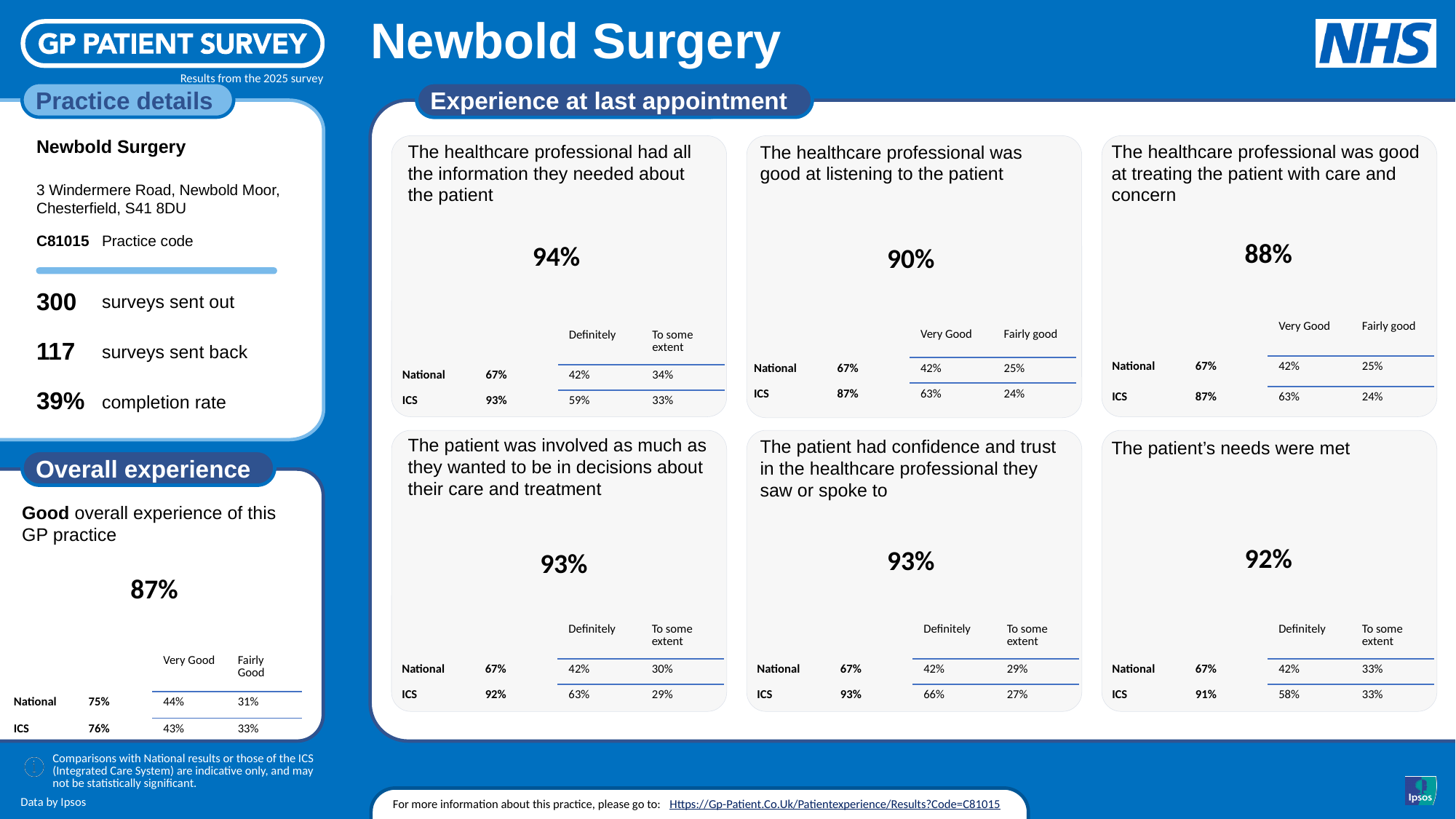
In the 'The patient had confidence and trust in the healthcare professional they saw or spoke to' panel, what is the ICS 'Definitely' value? 66% In the 'Experience at last appointment' section, what is the practice's value for 'The healthcare professional was good at listening to the patient'? 90% In the 'Overall experience' panel, what is the ICS 'Very Good' value? 43% In the 'Experience at last appointment' section, which statement has the highest practice percentage? The healthcare professional had all the information they needed about the patient In the 'Overall experience' panel, what is the difference between the practice value and the ICS value? 11% In the 'Overall experience' panel, what is the National value for good overall experience? 75% In the 'Experience at last appointment' section, which of the six statements has the lowest practice percentage? The healthcare professional was good at treating the patient with care and concern In the 'The patient's needs were met' panel, what is the difference between the practice value and the National value? 25% In the 'Experience at last appointment' section, what is the practice's value for 'The healthcare professional had all the information they needed about the patient'? 94% In the 'The healthcare professional was good at listening to the patient' panel, which is larger: the ICS 'Very Good' value or the National 'Very Good' value? ICS How many statement panels are shown in the 'Experience at last appointment' section? 6 In the 'Overall experience' panel, what percentage of patients reported a good overall experience of this GP practice? 87%